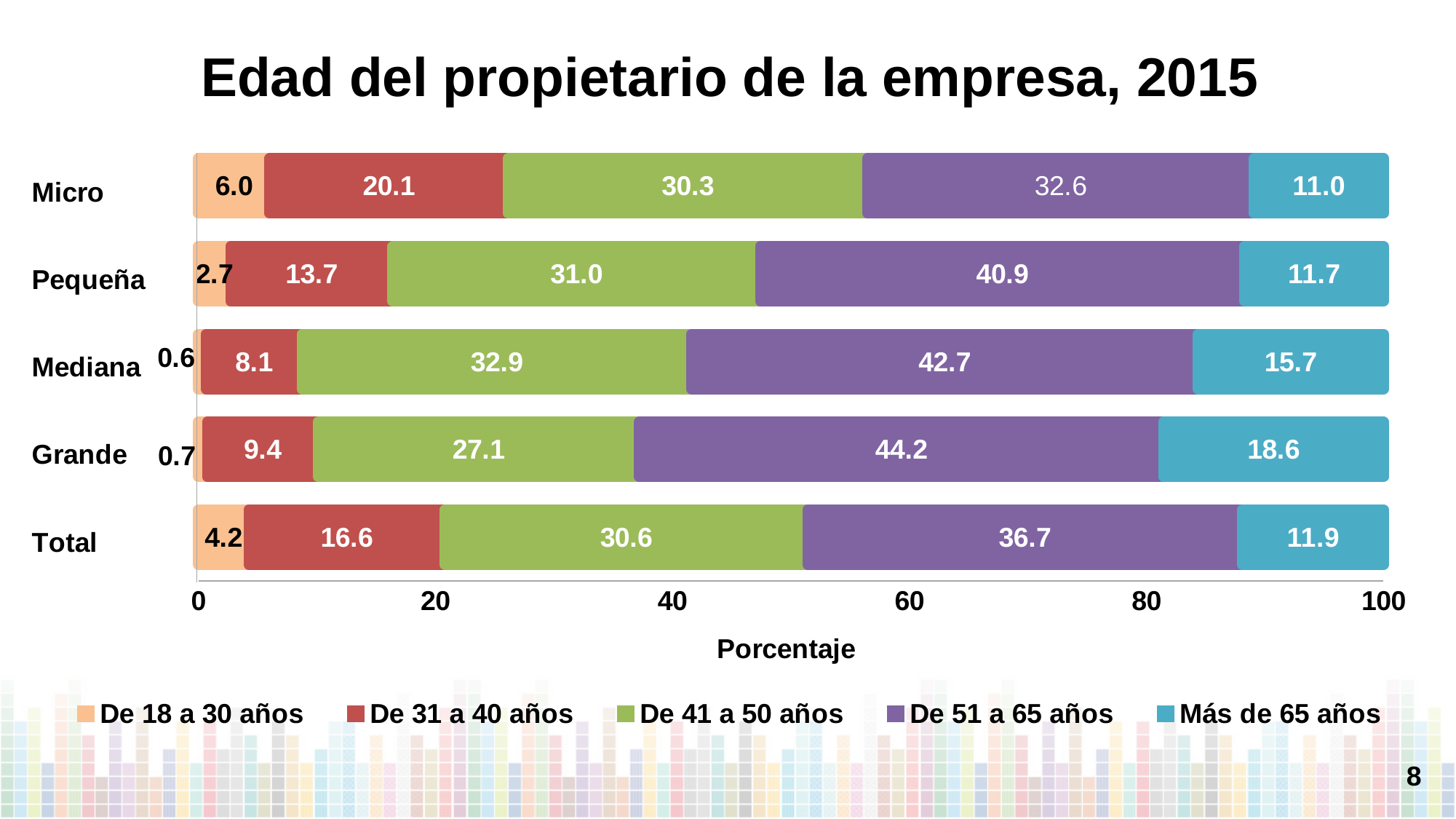
How many series does the legend list? 5 What is the value for 'Más de 65 años' in the Mediana category? 15.7 What is the total of the stacked bar for Total? 100.0 What is the value for 'De 18 a 30 años' in the Micro category? 6.0 What is the value for 'De 51 a 65 años' in the Grande category? 44.2 Which category has the highest value for 'De 51 a 65 años'? Grande Which is larger: the 'De 41 a 50 años' value for Mediana or for Grande? Mediana What type of chart is shown on the slide? Stacked bar chart Which category has the lowest value for 'De 18 a 30 años'? Mediana What is the difference between the 'De 31 a 40 años' values for Micro and Pequeña? 6.4 How many categories are shown on the y axis? 5 What is the title of the chart? Edad del propietario de la empresa, 2015